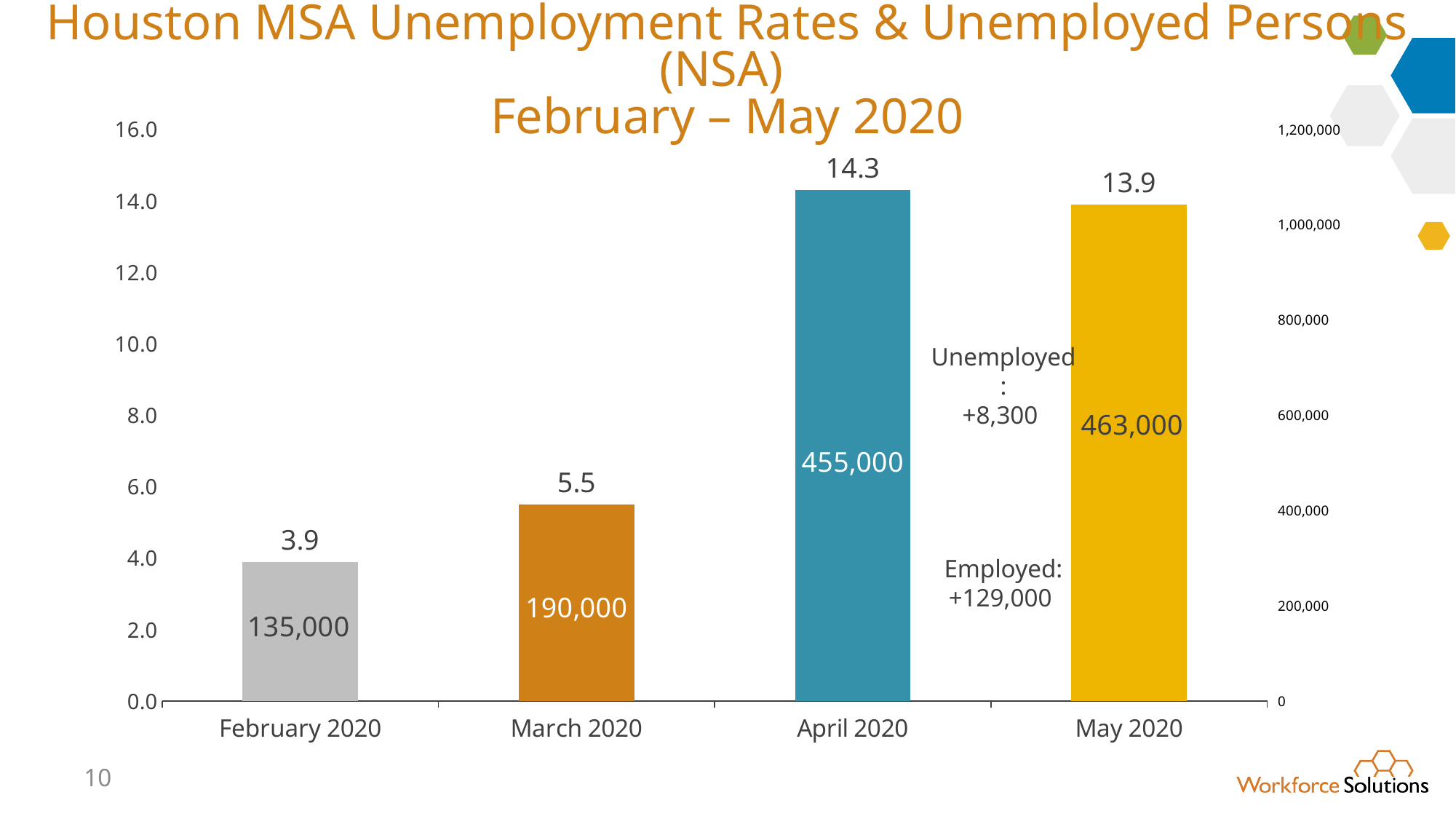
How many unemployed persons are shown for March 2020? 190,000 How many unemployed persons are shown for May 2020? 463,000 Which month has the lowest unemployment rate? February 2020 Which month has more unemployed persons, April 2020 or May 2020? May 2020 What is the unemployment rate shown for April 2020? 14.3 Which month has the highest unemployment rate? April 2020 What is the difference between the unemployment rates for April 2020 and March 2020? 8.8 What is the unemployment rate shown for February 2020? 3.9 What kind of chart is shown on the slide? Bar chart What is the difference in unemployed persons between May 2020 and April 2020? 8,000 What is the title of the chart? Houston MSA Unemployment Rates & Unemployed Persons (NSA) February – May 2020 How many months are shown on the x axis? 4